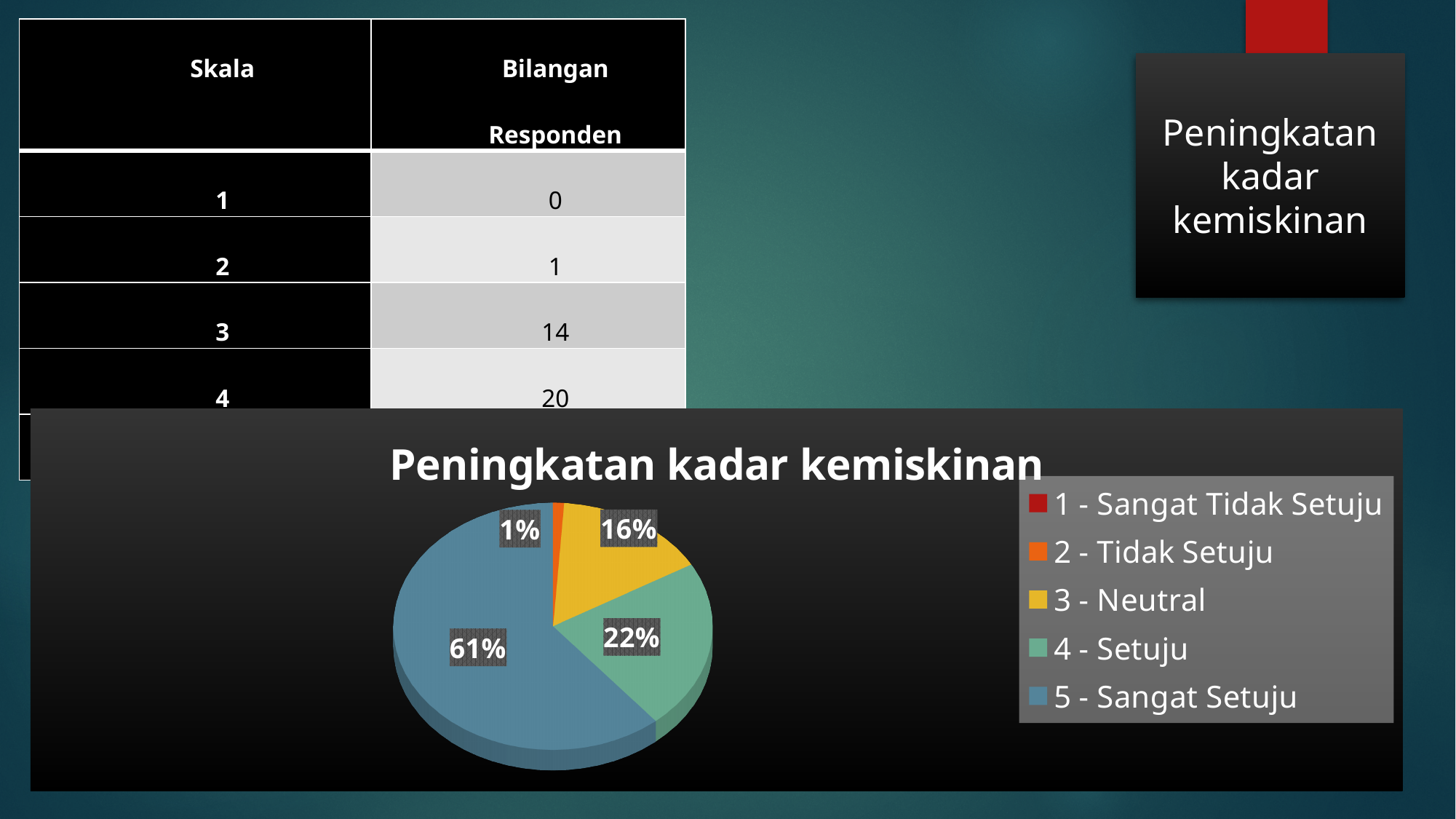
What kind of chart is shown on the slide? pie chart What share of the pie does "2 - Tidak Setuju" take? 1% What share of the pie does "4 - Setuju" take? 22% What share of the pie does "5 - Sangat Setuju" take? 61% Which legend entry is shown in red? 1 - Sangat Tidak Setuju Which category has the largest slice of the pie? 5 - Sangat Setuju What is the difference in percentage points between the "5 - Sangat Setuju" slice and the "4 - Setuju" slice? 39 Is the share for "5 - Sangat Setuju" greater or less than 50%? greater How many entries does the chart's legend list? 5 What is the title of the chart? Peningkatan kadar kemiskinan Which is larger, the slice for "3 - Neutral" or the slice for "4 - Setuju"? 4 - Setuju